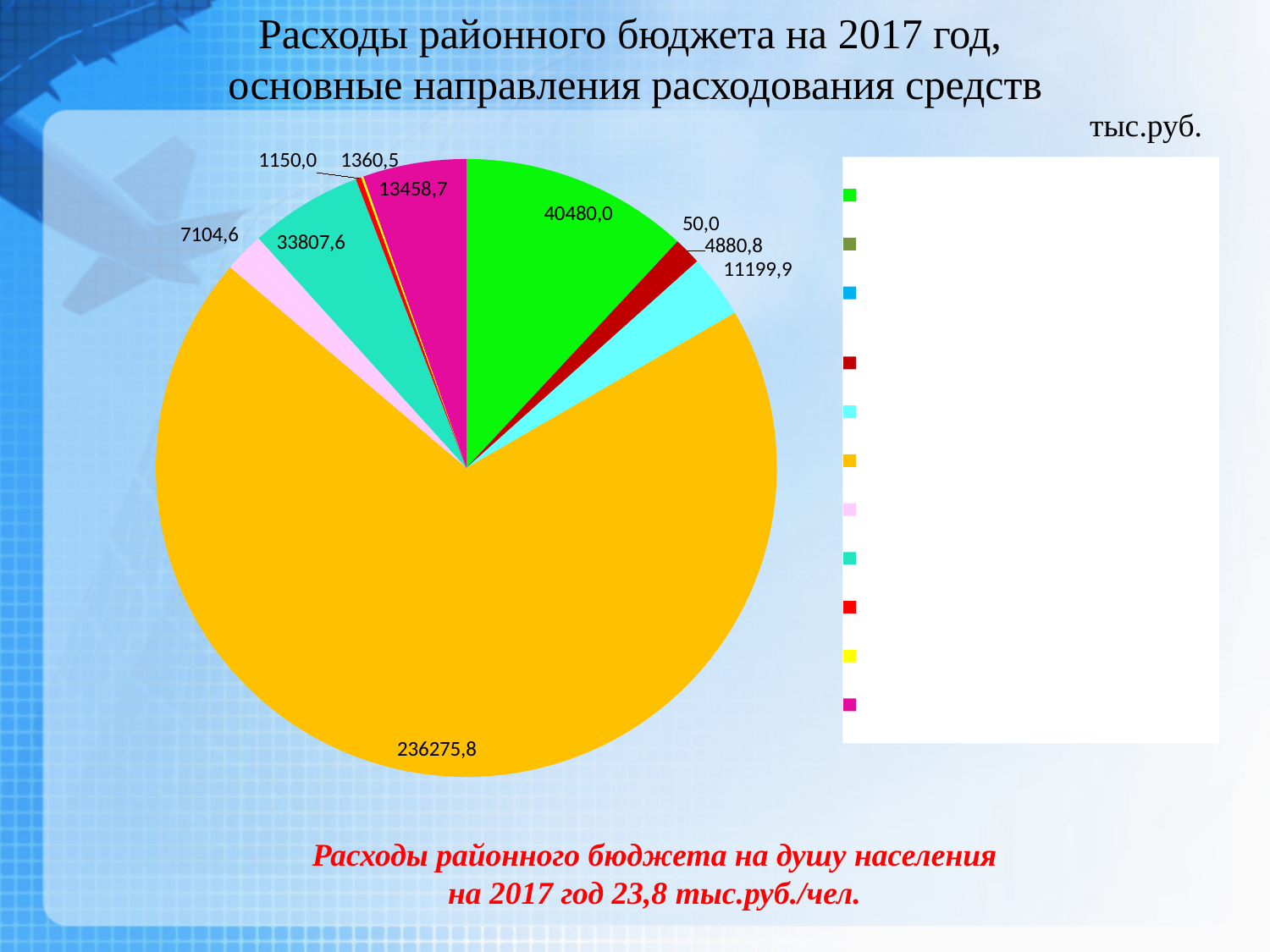
What value is labelled on the magenta slice of the pie chart? 13458,7 What value is labelled on the green slice of the pie chart? 40480,0 What is the smallest value labelled on the pie chart? 50,0 What value is labelled on the teal slice of the pie chart? 33807,6 What is the difference between the magenta slice (13458,7) and the cyan slice (11199,9)? 2258,8 What kind of chart is shown on the slide? pie chart In what units are the values of the pie chart given, according to the slide? тыс.руб. What is the value of the largest slice (orange) in the pie chart? 236275,8 How many colour entries does the legend of the pie chart list? 11 What is the difference between the green slice (40480,0) and the teal slice (33807,6)? 6672,4 Which slice is larger: the pink slice (7104,6) or the dark red slice (4880,8)? the pink slice (7104,6) What value is labelled on the light-blue (cyan) slice of the pie chart? 11199,9